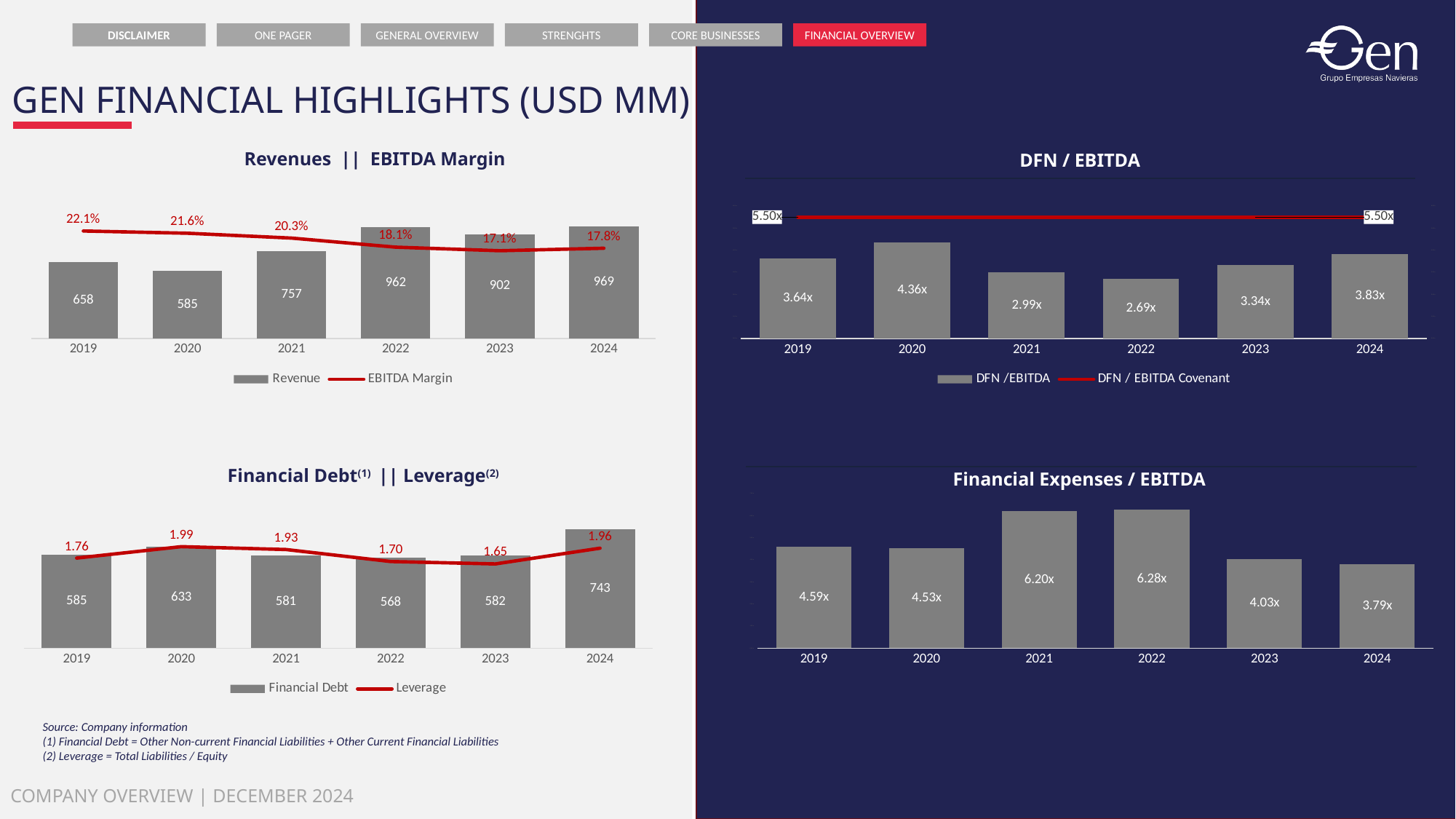
In the 'Revenues || EBITDA Margin' chart, what is the EBITDA margin for 2019? 22.1% In the 'Financial Debt || Leverage' chart, what is the leverage value for 2023? 1.65 In the 'Revenues || EBITDA Margin' chart, what is the revenue for 2022? 962 In the 'DFN / EBITDA' chart, what is the DFN / EBITDA Covenant level shown? 5.50x In the 'DFN / EBITDA' chart, what is the DFN / EBITDA value for 2020? 4.36x In the 'DFN / EBITDA' chart, which year has the lowest DFN / EBITDA value? 2022 In the 'Financial Expenses / EBITDA' chart, which year has the highest value? 2022 In the 'Financial Debt || Leverage' chart, what is the financial debt for 2024? 743 In the 'Revenues || EBITDA Margin' chart, what is the difference between the revenue in 2024 and the revenue in 2019? 311 In the 'Financial Expenses / EBITDA' chart, is the value for 2021 larger than the value for 2024? Yes How many series does the legend of the 'Financial Debt || Leverage' chart list? 2 In the 'Revenues || EBITDA Margin' chart, which year has the lowest revenue? 2020